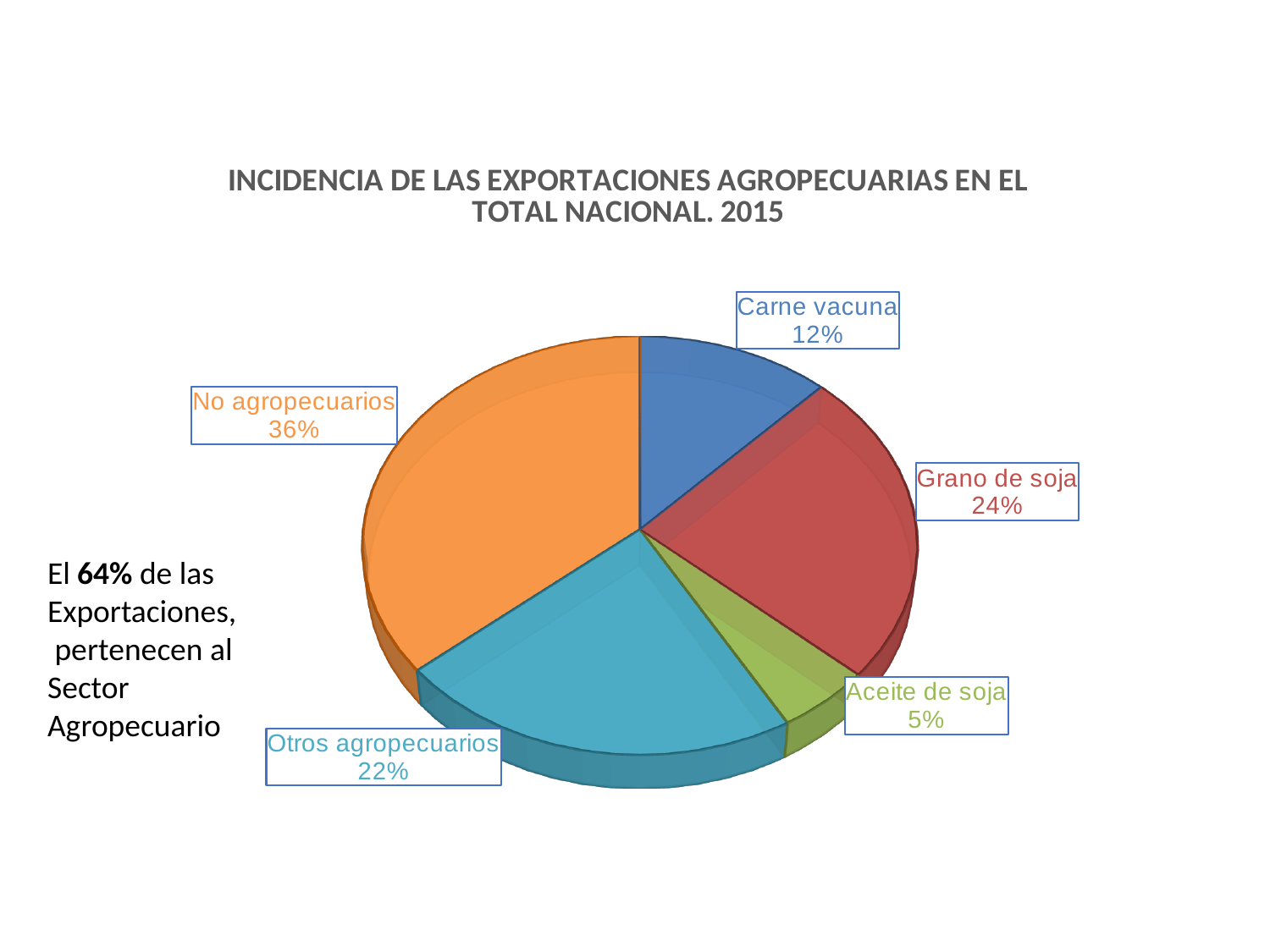
Which category has the largest slice of the pie? No agropecuarios What share of the pie does Grano de soja represent? 24% What share of the pie does Otros agropecuarios represent? 22% What share of the pie does Aceite de soja represent? 5% What kind of chart is shown on the slide? Pie chart Which is larger, the share for Carne vacuna or the share for Aceite de soja? Carne vacuna Which category has the smallest slice of the pie? Aceite de soja What is the title of the chart? INCIDENCIA DE LAS EXPORTACIONES AGROPECUARIAS EN EL TOTAL NACIONAL. 2015 How many slices does the pie chart have? 5 What is the difference in percentage points between Grano de soja and Otros agropecuarios? 2%